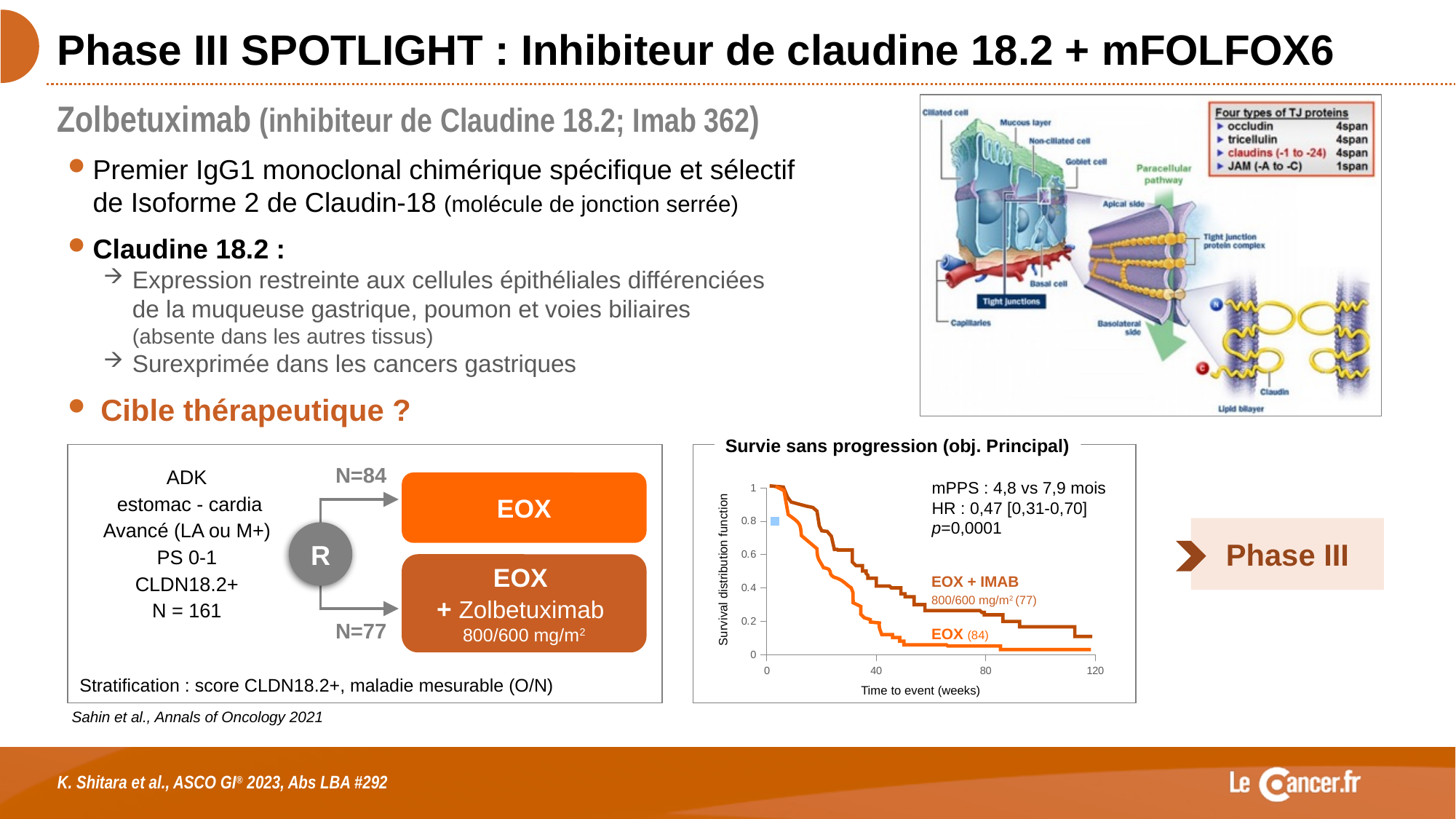
What p-value is printed on the 'Survie sans progression' chart? p=0,0001 How many patients are in the EOX + IMAB arm according to the legend of the 'Survie sans progression' chart? 77 On the 'Survie sans progression' chart, do the survival curves rise or fall as time increases? fall On the 'Survie sans progression' chart, is the EOX + IMAB curve at 60 weeks greater or less than 0.2? greater What median PFS values (mPPS) are printed on the 'Survie sans progression' chart? 4,8 vs 7,9 mois How many survival curves (series) are plotted on the 'Survie sans progression' chart? 2 On the 'Survie sans progression' chart, is the EOX curve at 80 weeks greater or less than 0.2? less What hazard ratio is printed on the 'Survie sans progression' chart? 0,47 [0,31-0,70] How many patients are in the EOX arm according to the legend of the 'Survie sans progression' chart? 84 On the 'Survie sans progression' chart, which curve stays higher over time, EOX + IMAB or EOX? EOX + IMAB What kind of chart is shown under the title 'Survie sans progression (obj. Principal)'? line chart (Kaplan-Meier survival curve) What is the label of the x axis on the 'Survie sans progression' chart? Time to event (weeks)